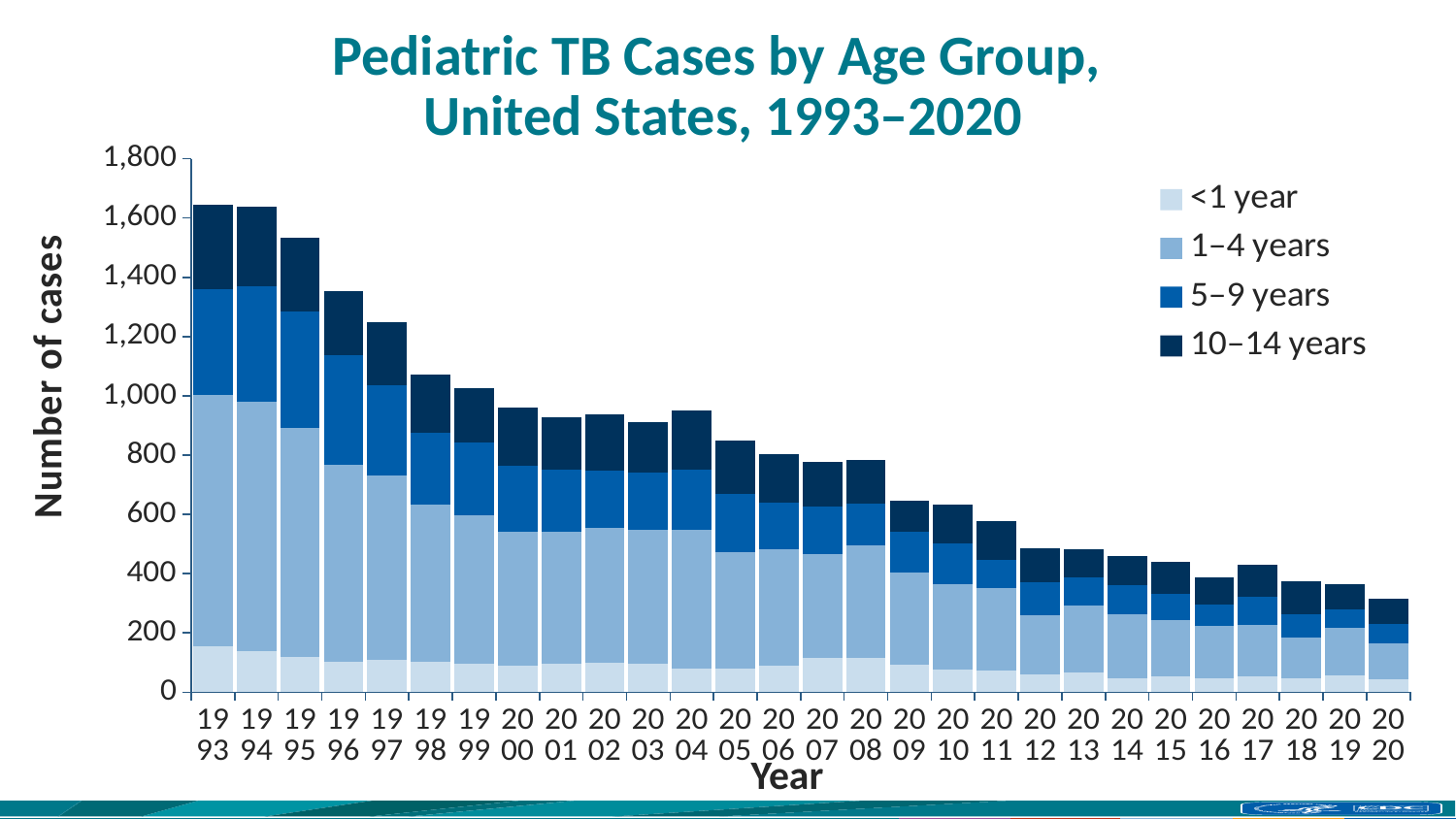
Which year has a higher total number of cases, 1995 or 2000? 1995 What is the label on the y axis? Number of cases Is the total number of cases in 1993 greater or less than 1,600? greater Is the total number of cases in 2020 greater or less than 400? less Which year has the lowest total number of pediatric TB cases? 2020 What kind of chart is shown on the slide? stacked bar chart How many age-group series does the legend list? 4 How many years are plotted along the x axis? 28 Overall, do the total number of cases rise or fall from 1993 to 2020? fall Which year has a higher total number of cases, 2008 or 2009? 2008 Is the total number of cases in 2012 greater or less than 600? less